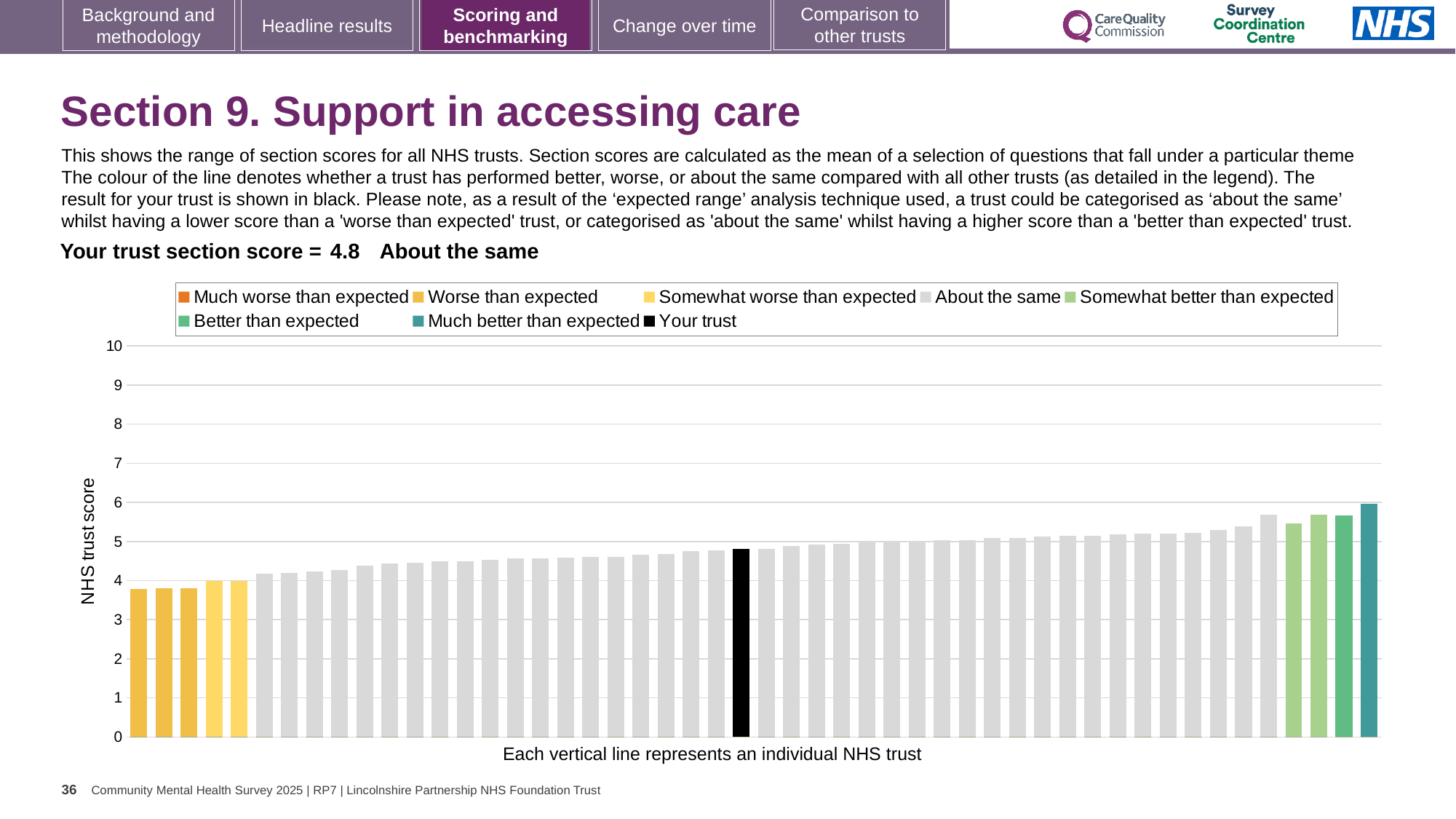
What colour is used for the bar representing your trust? black How many trusts are shown in the 'Much better than expected' colour? 1 Is the value for the lowest-scoring trust greater or less than 4? less How many trusts are shown in the 'Better than expected' colour? 1 How many entries does the chart legend list? 8 What is the section score for your trust? 4.8 Is the value for the highest-scoring trust greater or less than 5? greater What kind of chart is shown on the slide? bar chart Is the value for your trust greater or less than 5? less Which category is your trust placed in for this section? About the same What is the label on the vertical axis of the chart? NHS trust score Do the trust scores rise or fall from left to right along the x axis? rise